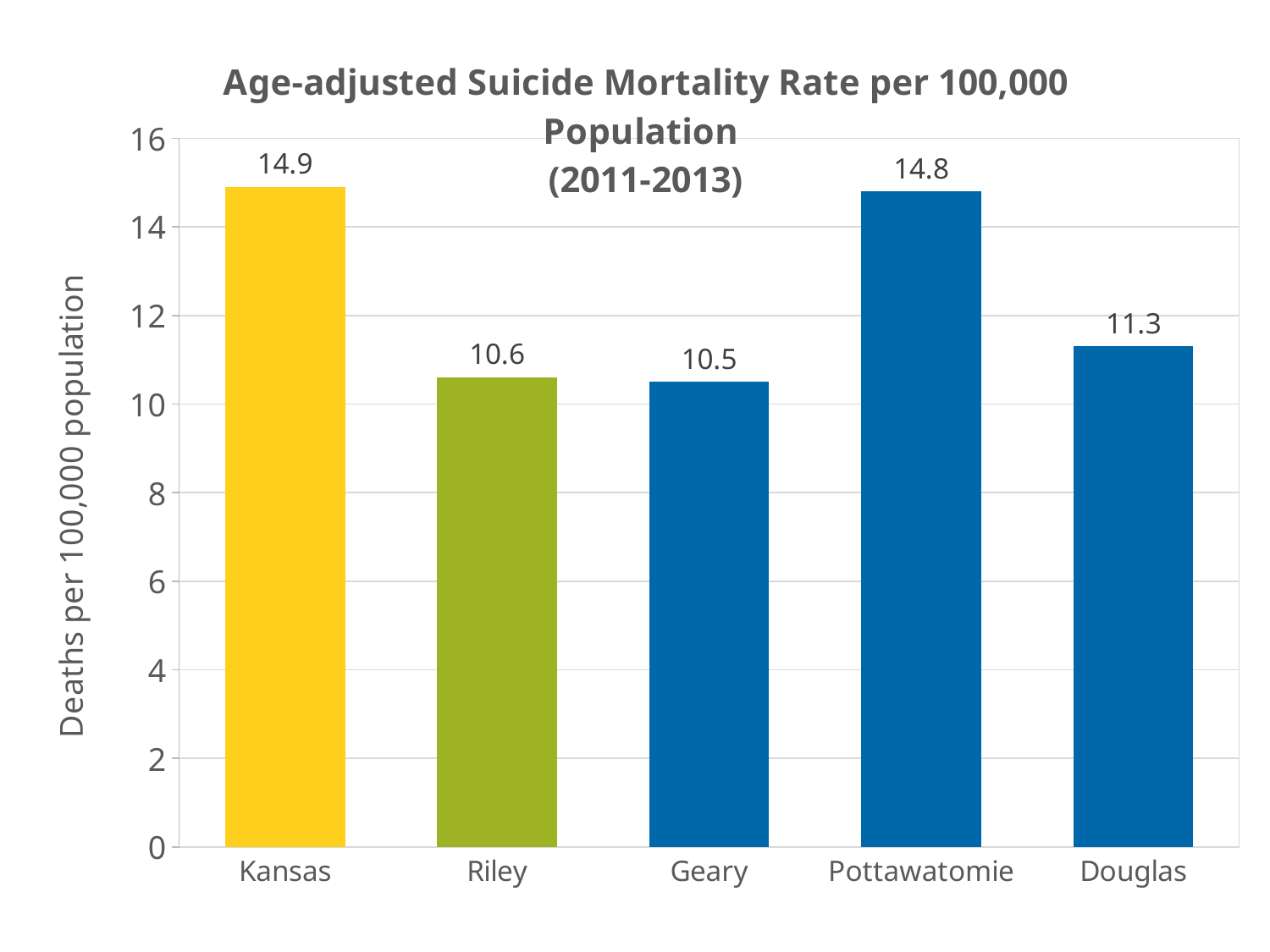
Is the value for Douglas greater or less than 12? less Which is larger, the value for Pottawatomie or the value for Riley? Pottawatomie What is the difference between the values for Pottawatomie and Geary? 4.3 What is the age-adjusted suicide mortality rate for Kansas? 14.9 Which category has the highest value? Kansas What is the difference between the values for Kansas and Douglas? 3.6 What is the value shown for Douglas? 11.3 Which category has the lowest value? Geary What kind of chart is shown on the slide? bar chart What is the label of the vertical axis? Deaths per 100,000 population What is the value shown for Riley? 10.6 How many categories are shown on the x axis? 5